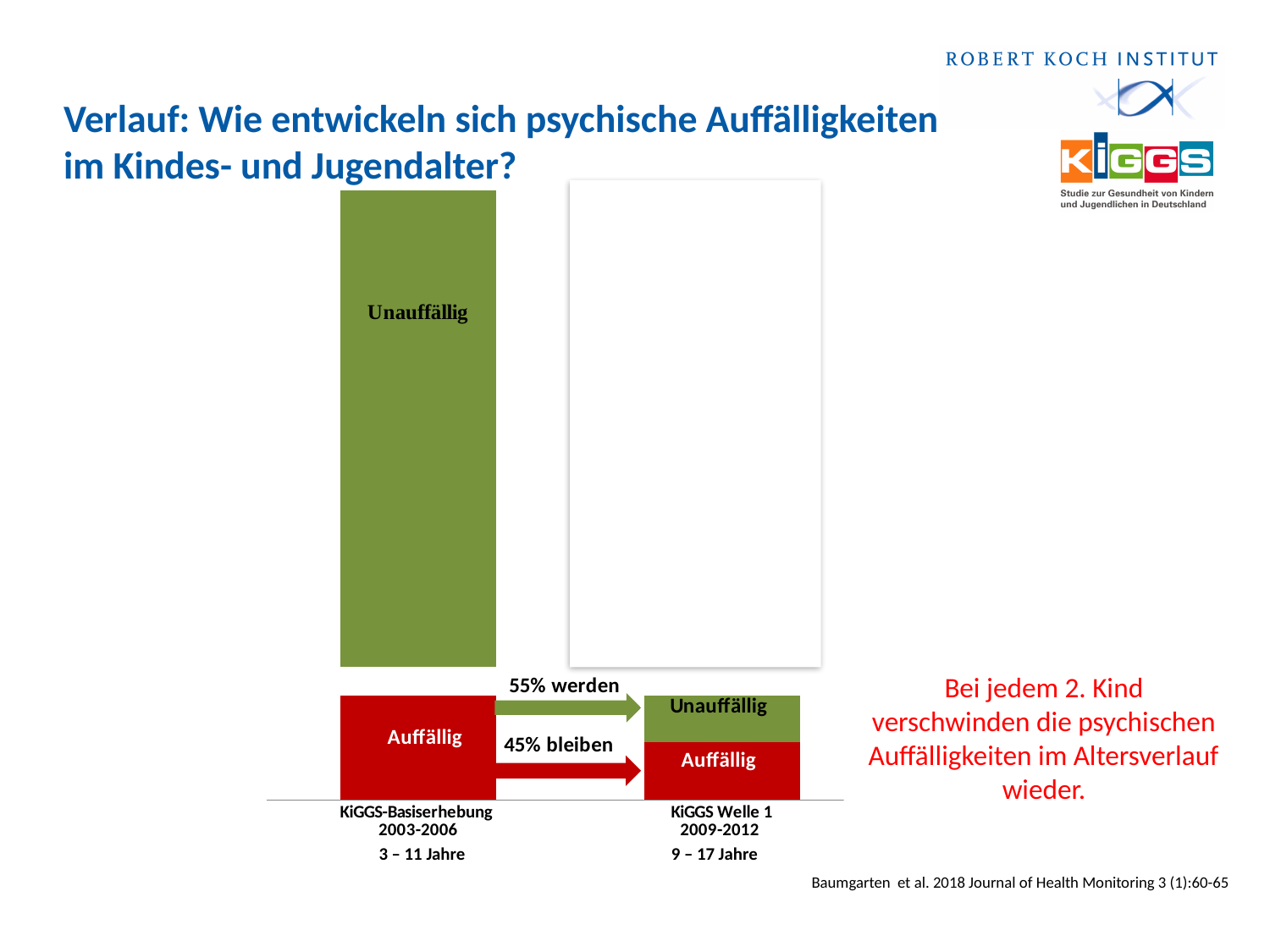
According to the arrow label, what percentage of children who were 'Auffällig' in the KiGGS-Basiserhebung become 'Unauffällig' in KiGGS Welle 1? 55% werden What kind of chart is shown on the slide? stacked bar chart According to the arrow label, what percentage of children who were 'Auffällig' in the KiGGS-Basiserhebung remain 'Auffällig' in KiGGS Welle 1? 45% bleiben What age range is given for the KiGGS Welle 1 2009-2012 bar? 9 – 17 Jahre In the KiGGS-Basiserhebung 2003-2006 bar, which segment is larger, 'Unauffällig' or 'Auffällig'? Unauffällig Which is larger: the share of children who become 'Unauffällig' (55%) or the share who remain 'Auffällig' (45%)? 55% werden How many bars (survey waves) are shown on the x axis of the chart? 2 What age range is given for the KiGGS-Basiserhebung 2003-2006 bar? 3 – 11 Jahre What is the title of the slide containing the chart? Verlauf: Wie entwickeln sich psychische Auffälligkeiten im Kindes- und Jugendalter? What are the two categories shown within the bars of the chart? Unauffällig and Auffällig What is the difference between the share that becomes 'Unauffällig' (55%) and the share that remains 'Auffällig' (45%)? 10% What colour is used for the 'Auffällig' segment in the chart? red